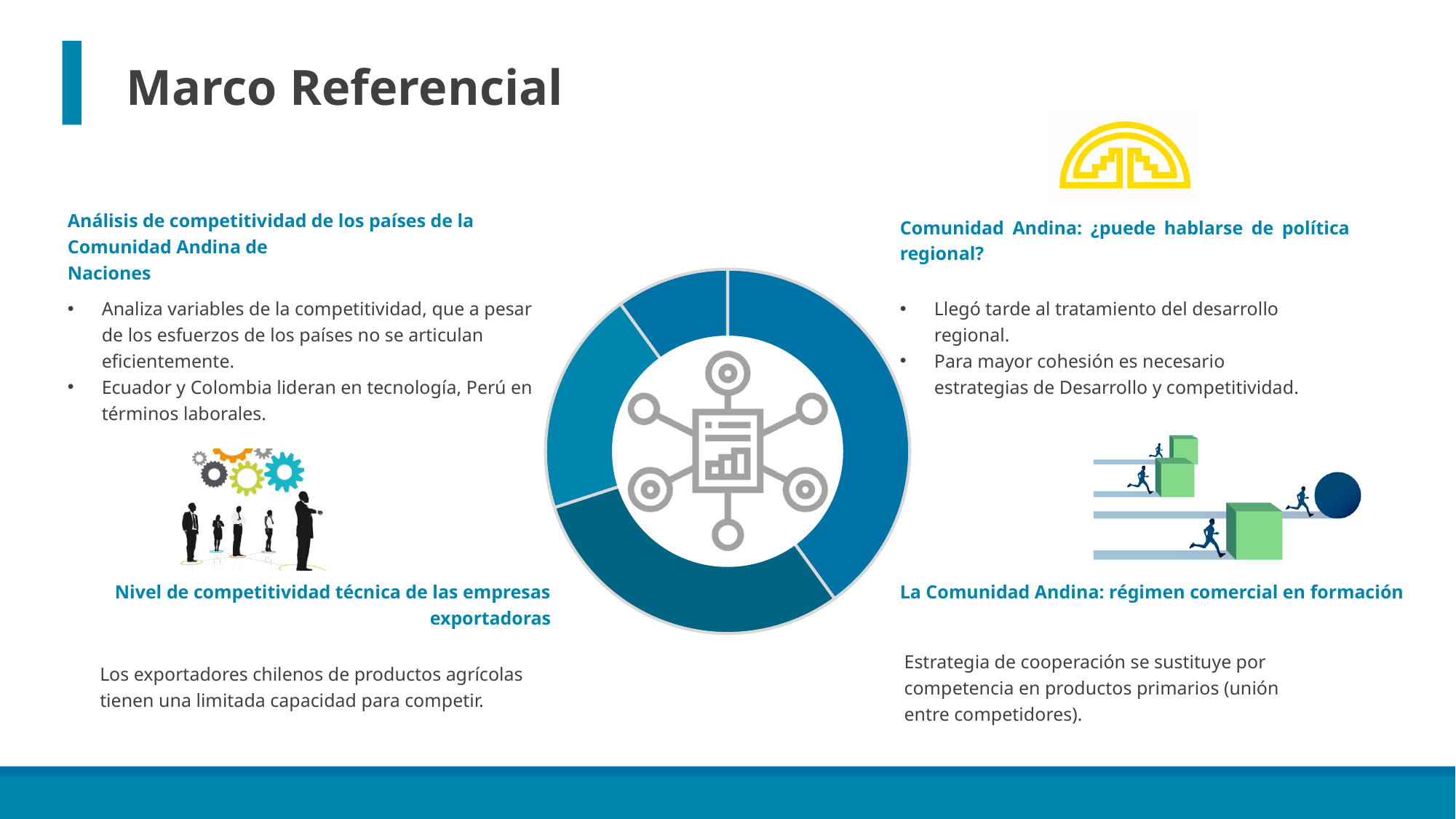
In the doughnut chart, is the large dark blue segment on the right larger or smaller than the small segment at the top left? Larger Does the doughnut chart in the centre of the slide have a legend? No Does the doughnut chart in the centre of the slide show any data labels or values? No Which segment of the doughnut chart is the smallest: the one at the top left or the one on the right? The one at the top left How many segments does the doughnut chart in the centre of the slide have? 4 What kind of chart is shown in the centre of the slide? A doughnut (pie) chart